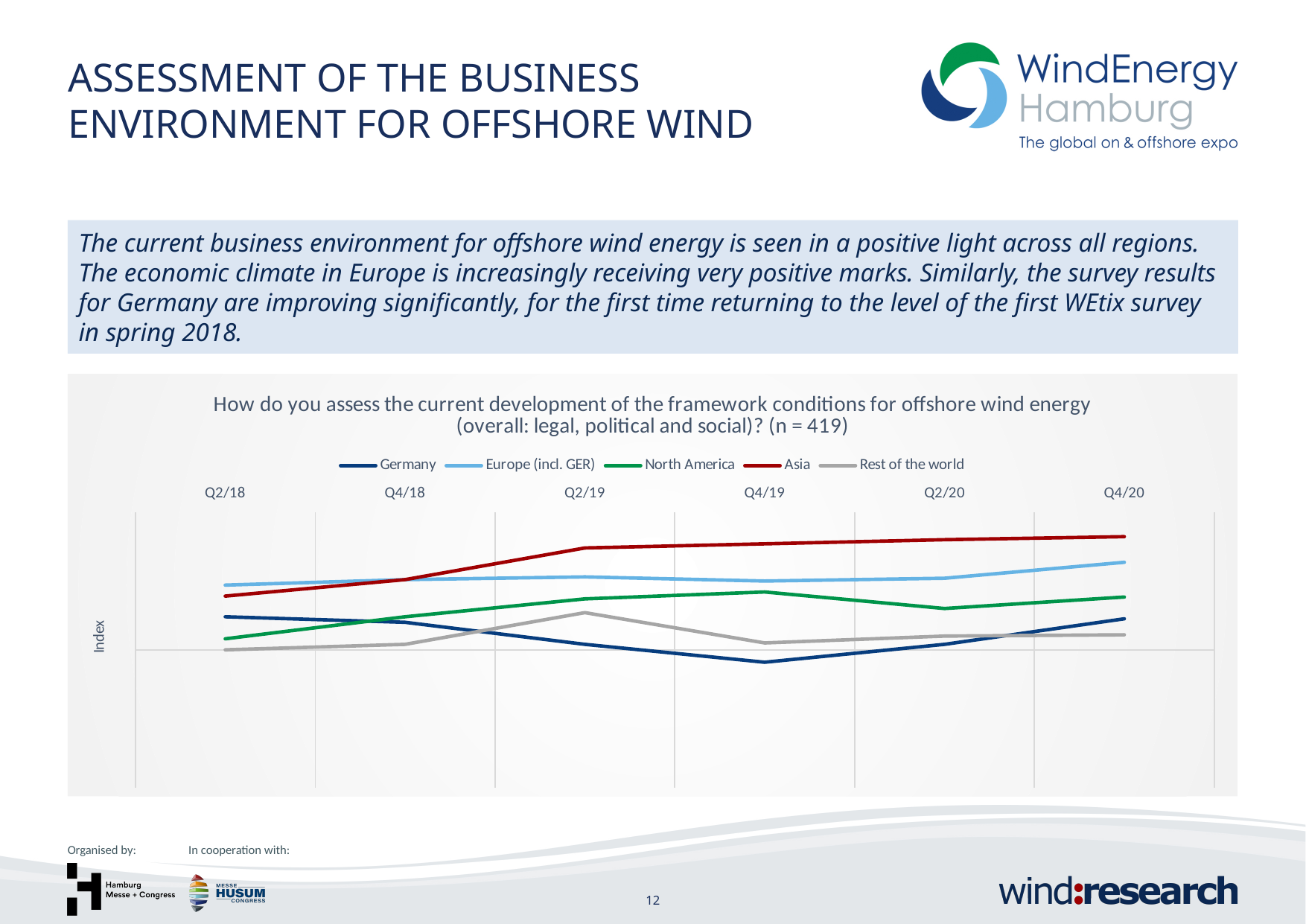
At Q4/19, which is higher: Germany or Europe (incl. GER)? Europe (incl. GER) Which region has the lowest index value at Q4/19? Germany Which region has the highest index value at Q4/19? Asia What is the sample size (n) stated in the chart title? 419 Which region has the highest index value at Q4/20? Asia How many time points are shown along the x axis of the chart? 6 How many series does the chart's legend list? 5 What kind of chart is shown on the slide? Line chart Does the Germany line rise or fall from Q2/18 to Q4/19? Fall Which region has the lowest index value at Q2/18? Rest of the world Does the Asia line rise or fall from Q2/18 to Q4/20? Rise At Q4/20, which is higher: Asia or North America? Asia